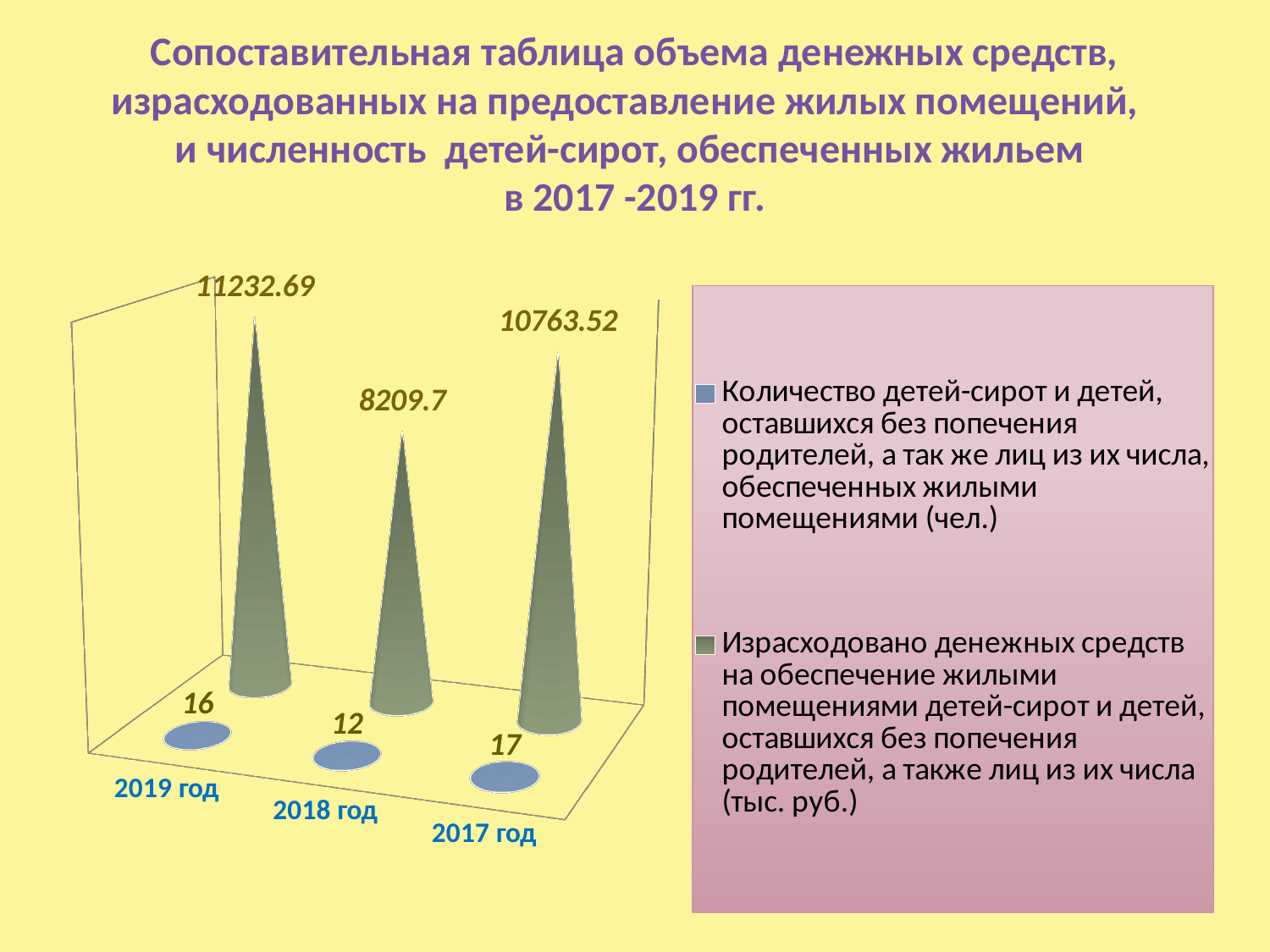
How many children (чел.) were provided with housing in 2018 год? 12 How many years (categories) are shown on the chart? 3 Which year has the lowest number of children provided with housing (чел.)? 2018 год What is the difference in the number of children (чел.) between 2017 год and 2019 год? 1 Which year had more money spent (тыс. руб.): 2017 год or 2018 год? 2017 год What kind of chart is shown on the slide? bar chart (3D cone) What is the value of the money-spent series (тыс. руб.) for 2018 год? 8209.7 What is the value of the money-spent series (Израсходовано денежных средств, тыс. руб.) for 2019 год? 11232.69 What is the difference in money spent (тыс. руб.) between 2019 год and 2018 год? 3022.99 How many series does the legend list? 2 How many children (Количество детей-сирот, чел.) were provided with housing in 2017 год? 17 Which year has the highest amount of money spent (тыс. руб.)? 2019 год